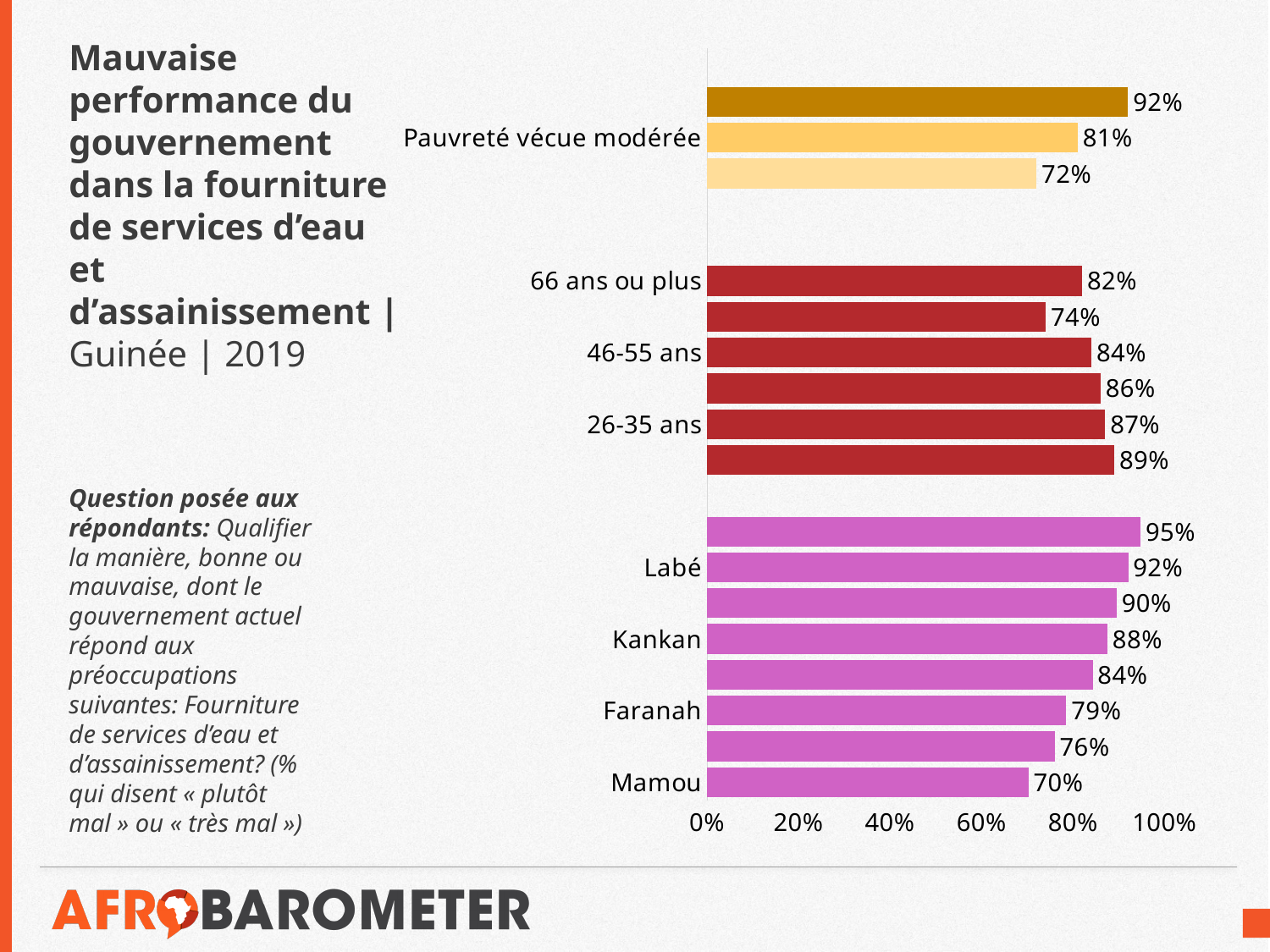
What is the value for 66 ans ou plus? 82% Which labeled category has the lowest value on the chart? Mamou How many bars are plotted on the chart? 17 Which country and year does the chart title refer to? Guinée | 2019 What is the highest value shown on the chart? 95% What is the value for Mamou? 70% What is the value for Labé? 92% What is the value for Pauvreté vécue modérée? 81% What is the value for 26-35 ans? 87% What kind of chart is shown on the slide? Bar chart Which is larger, the value for 46-55 ans or the value for 66 ans ou plus? 46-55 ans What is the difference between the values for Kankan and Faranah? 9%